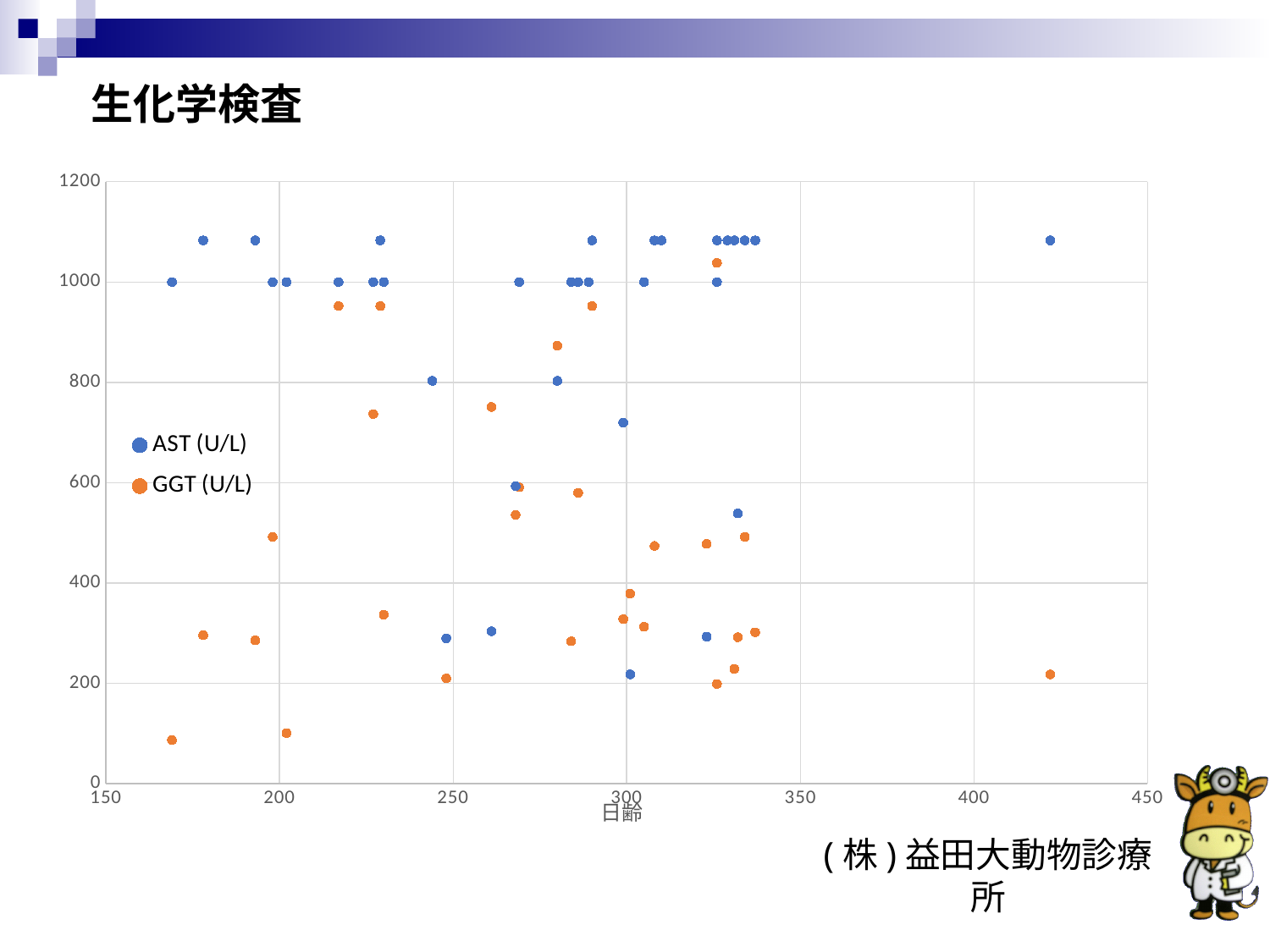
Near 日齢 420, which series has the higher value, AST (U/L) or GGT (U/L)? AST (U/L) Is the value of the rightmost GGT (U/L) point, near 日齢 420, greater or less than 400? less How many series does the legend list? 2 What is the label of the x axis? 日齢 Is the value of the leftmost AST (U/L) point, near 日齢 170, greater or less than 800? greater Is the value of the rightmost AST (U/L) point, near 日齢 420, greater or less than 1000? greater Near 日齢 170, which series has the higher value, AST (U/L) or GGT (U/L)? AST (U/L) What are the two series named in the legend? AST (U/L) and GGT (U/L) What kind of chart is shown on the slide? scatter chart